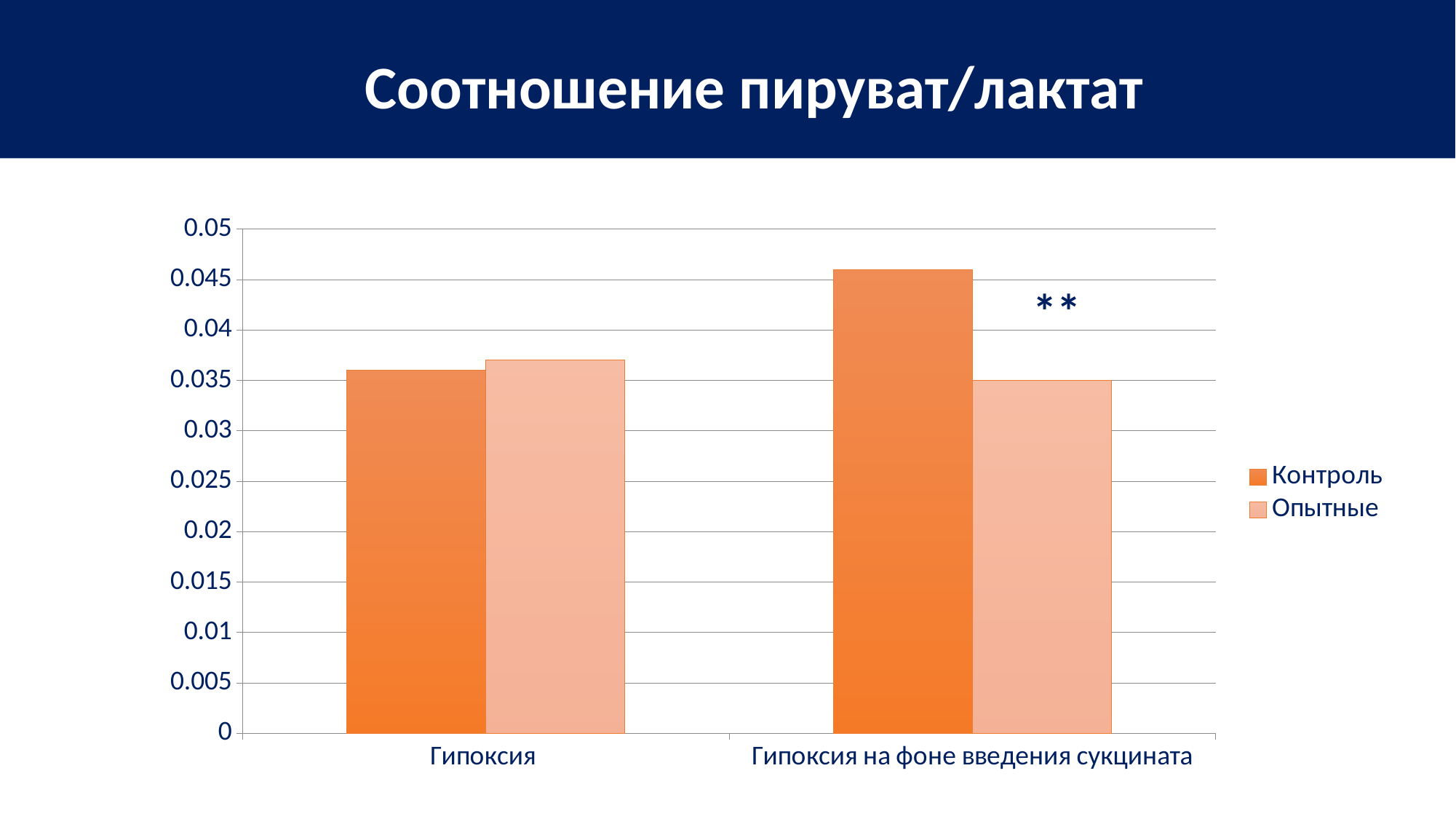
For the category Гипоксия на фоне введения сукцината, which series has the larger value, Контроль or Опытные? Контроль How many series does the legend list? 2 Is the Контроль value for Гипоксия на фоне введения сукцината greater or less than 0.04? greater What is the title of the chart? Соотношение пируват/лактат Which series and category has the highest bar? Контроль, Гипоксия на фоне введения сукцината Is the Контроль value for Гипоксия greater or less than 0.03? greater Does the Контроль series rise or fall from Гипоксия to Гипоксия на фоне введения сукцината? rise Is the Опытные value for Гипоксия greater or less than 0.04? less For the Контроль series, which category has the larger value, Гипоксия or Гипоксия на фоне введения сукцината? Гипоксия на фоне введения сукцината What kind of chart is shown on the slide? bar chart How many categories are shown on the x axis? 2